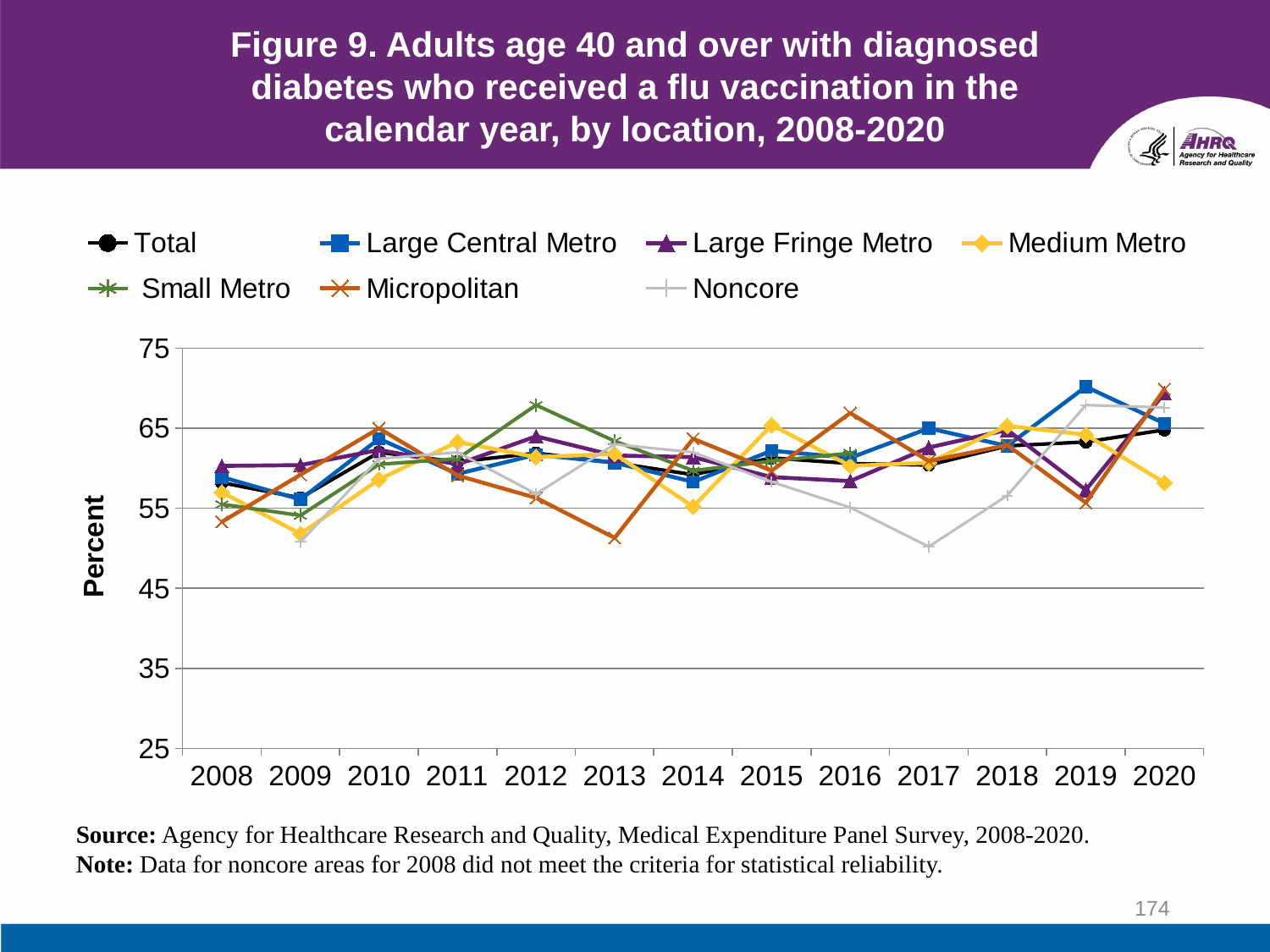
Is the value for Small Metro in 2012 greater or less than 65? greater Is the value for Medium Metro in 2009 greater or less than 55? less How many series does the legend list? 7 How many years are plotted along the x axis? 13 Does the Total series rise or fall overall from 2008 to 2020? Rise Is the value for Noncore in 2017 greater or less than 55? less According to the note, data for which location in 2008 did not meet the criteria for statistical reliability? Noncore In 2019, which is larger: the value for Large Central Metro or the value for Medium Metro? Large Central Metro In 2016, which is larger: the value for Micropolitan or the value for Noncore? Micropolitan What kind of chart is shown on the slide? Line chart